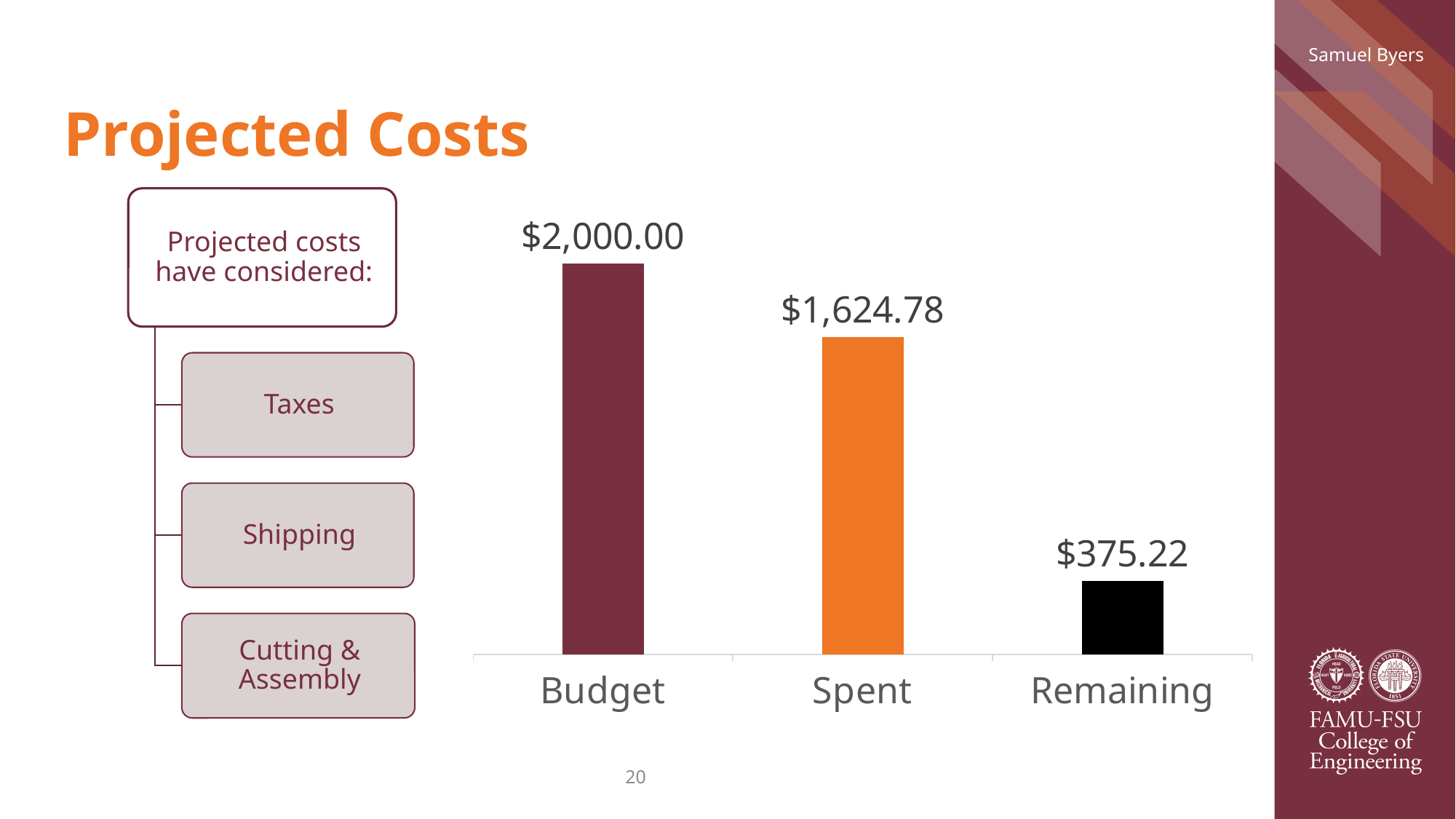
What is the difference between the Budget and Spent values? $375.22 What is the difference between the Spent and Remaining values? $1,249.56 Do the values rise or fall from left to right across the categories? Fall Which category has the highest value? Budget What is the value of the Budget bar? $2,000.00 What is the value of the Remaining bar? $375.22 How many categories are shown in the chart? 3 What is the value of the Spent bar? $1,624.78 What colour is the Spent bar? Orange What kind of chart is shown on the slide? Bar chart Which is larger, Spent or Remaining? Spent Which category has the lowest value? Remaining